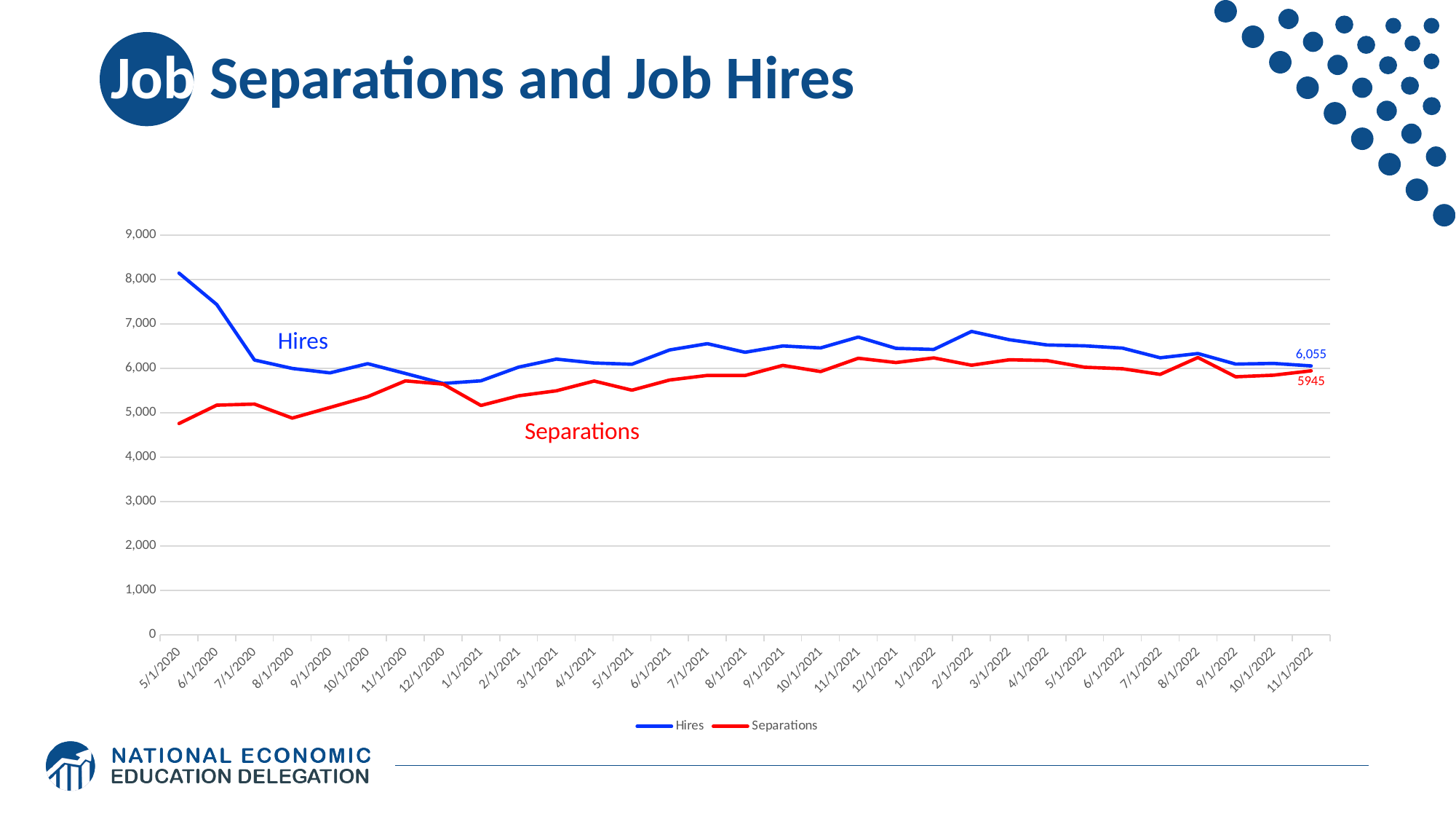
What is the value of Separations at 11/1/2022? 5945 What kind of chart is shown on the slide? Line chart What is the value of Hires at 11/1/2022? 6,055 How many series does the legend list? 2 What is the difference between Hires and Separations at 11/1/2022? 110 At 11/1/2022, which series has the larger value, Hires or Separations? Hires Is the value for Separations at 5/1/2020 greater or less than 5,000? less At which date is the Separations series at its lowest? 5/1/2020 Do the Hires values rise or fall from 5/1/2020 to 7/1/2020? Fall Is the value for Hires at 5/1/2020 greater or less than 8,000? greater At which date is the Hires series at its highest? 5/1/2020 Is the value for Separations at 8/1/2020 greater or less than 5,000? less